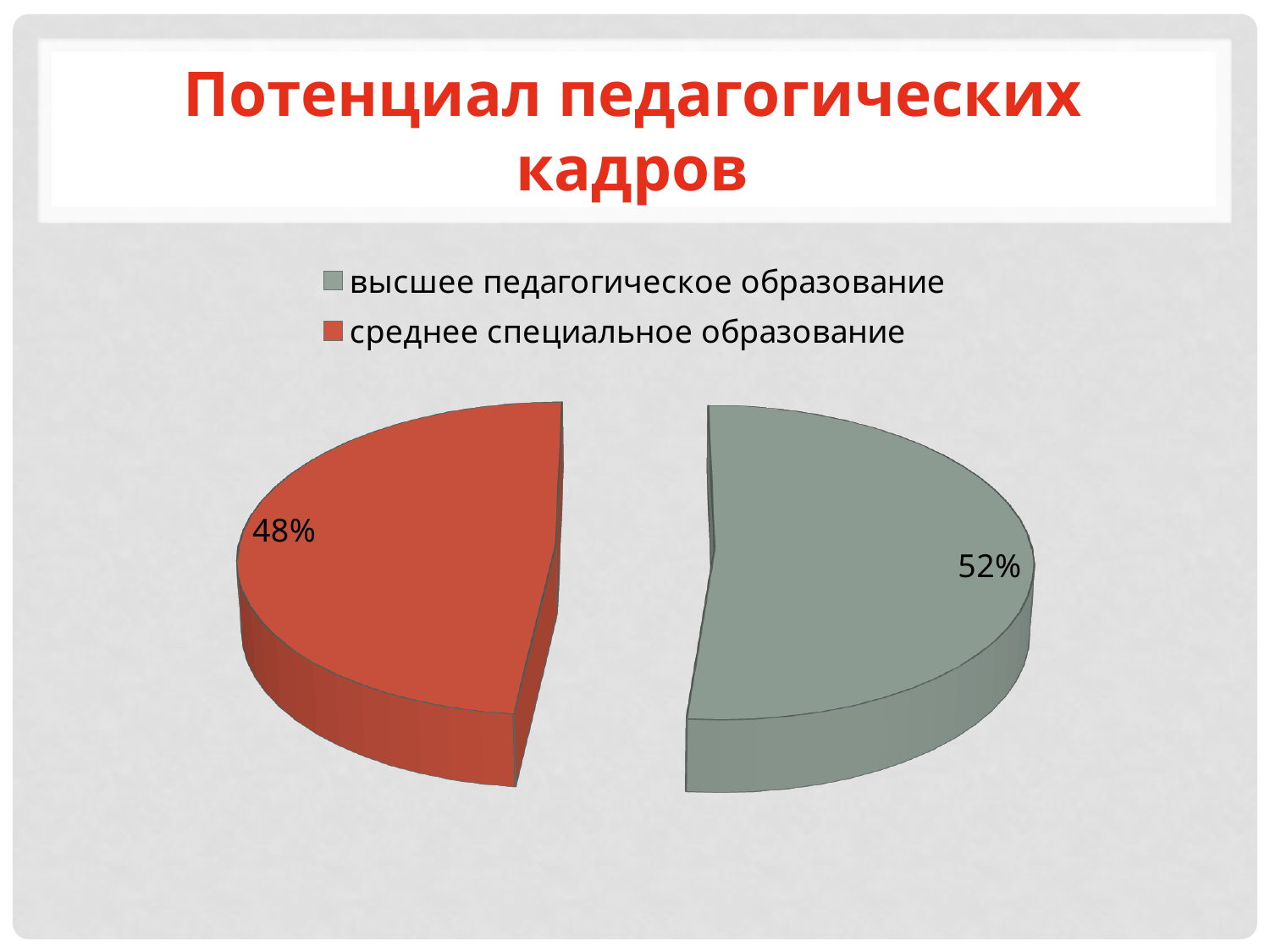
What kind of chart is shown on the slide? pie chart How many slices does the pie chart have? 2 How many entries does the legend list? 2 What is the title of the slide? Потенциал педагогических кадров What share of the pie does "среднее специальное образование" have? 48% What colour is the slice for "среднее специальное образование"? red Which is larger: the share for "высшее педагогическое образование" or for "среднее специальное образование"? высшее педагогическое образование Which category has the largest slice of the pie? высшее педагогическое образование Which category has the smallest slice of the pie? среднее специальное образование What share of the pie does "высшее педагогическое образование" have? 52% What is the difference in percentage points between the two slices? 4%